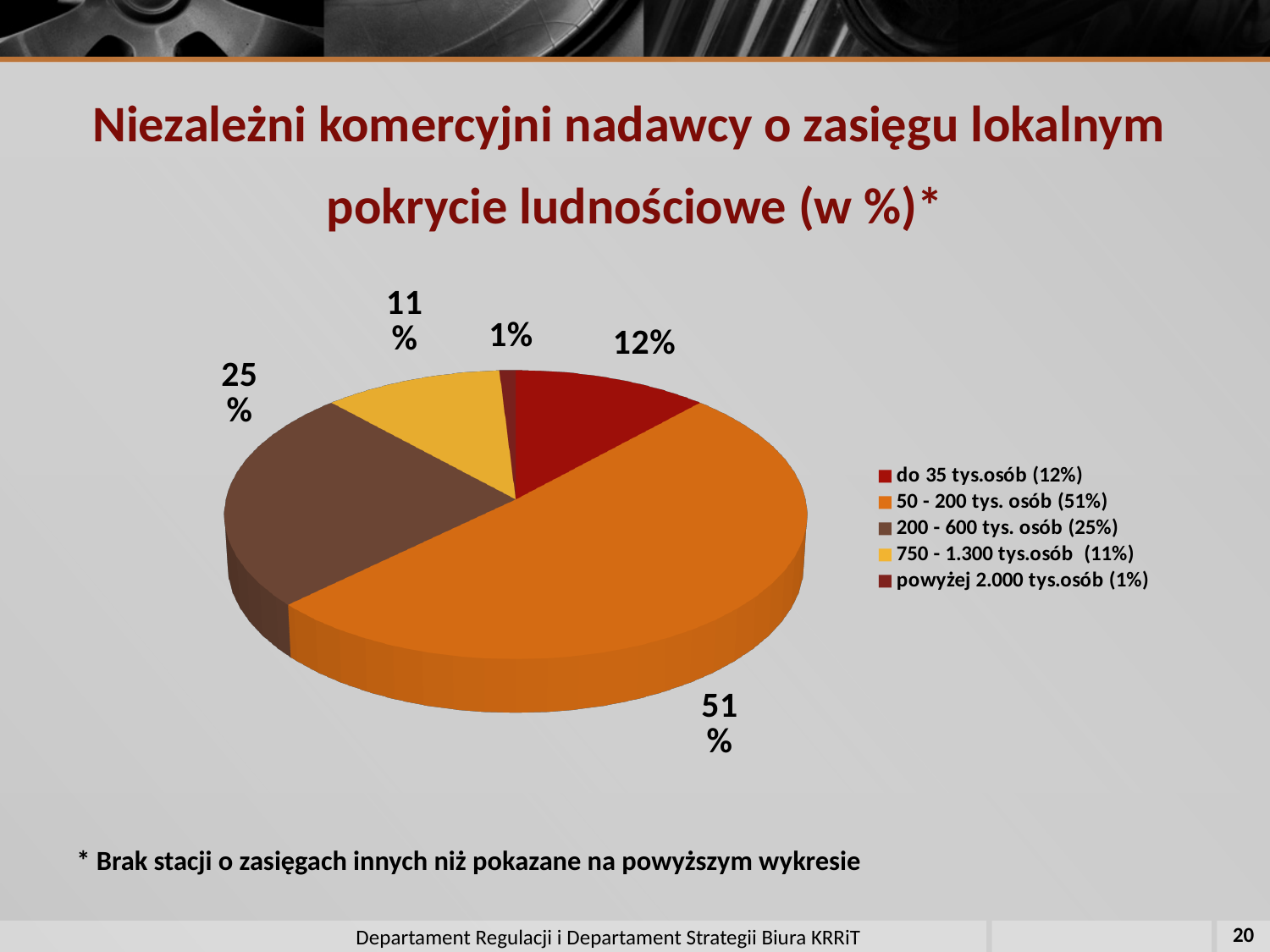
What is the value shown for '200 - 600 tys. osób'? 25% What kind of chart is shown on the slide? pie chart What is the value shown for 'powyżej 2.000 tys.osób'? 1% How many slices does the pie chart have? 5 What is the value shown for 'do 35 tys.osób'? 12% Which is larger, the share for 'do 35 tys.osób' or for '750 - 1.300 tys.osób'? do 35 tys.osób What is the difference between the shares for '50 - 200 tys. osób' and '200 - 600 tys. osób'? 26% What is the value shown for '750 - 1.300 tys.osób'? 11% Which category has the largest share of the pie? 50 - 200 tys. osób What colour is the slice for '200 - 600 tys. osób'? brown Which category has the smallest share of the pie? powyżej 2.000 tys.osób What share of the pie does the '50 - 200 tys. osób' slice represent? 51%